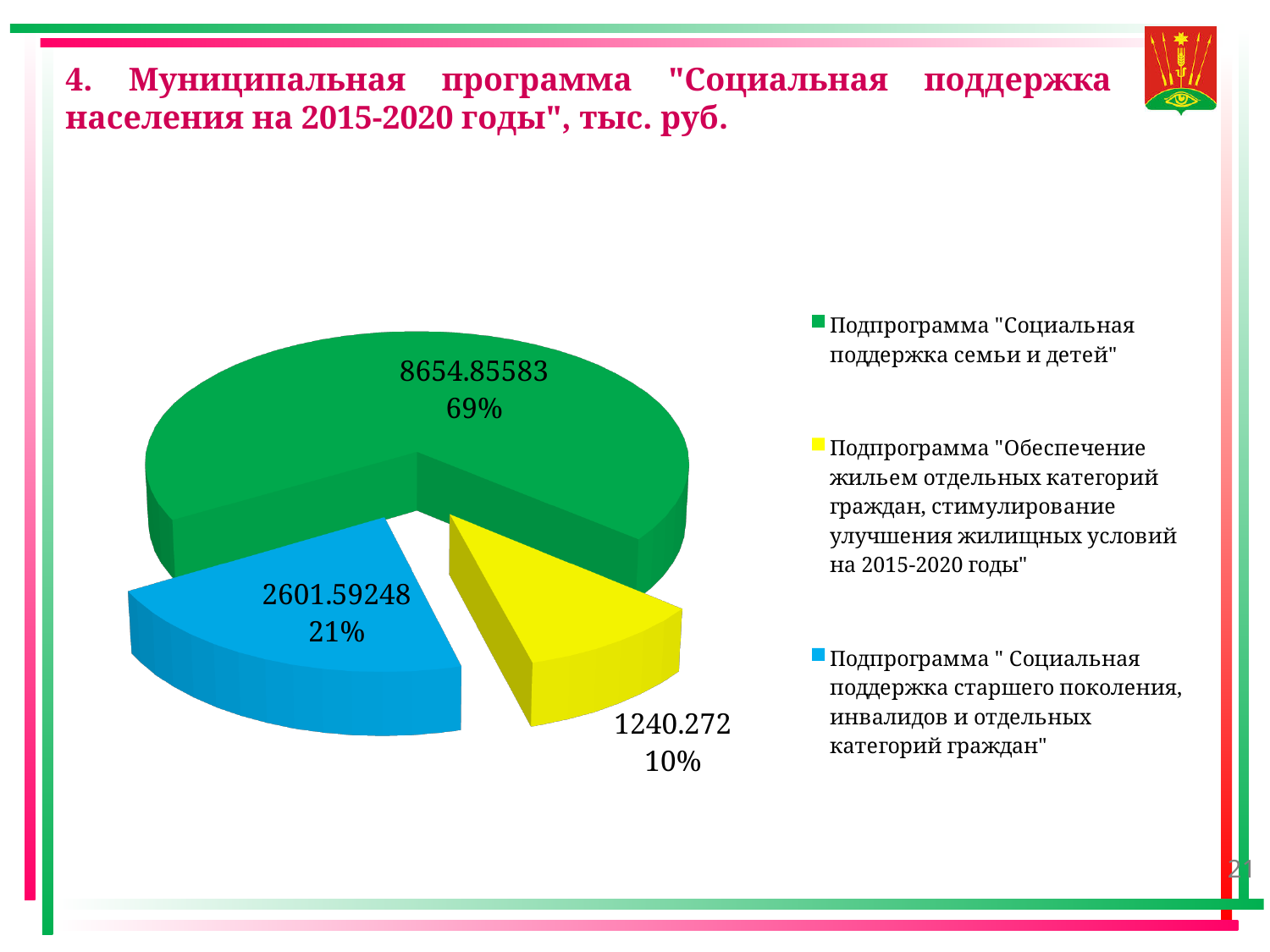
What share of the pie does Подпрограмма "Обеспечение жильем отдельных категорий граждан, стимулирование улучшения жилищных условий на 2015-2020 годы" take? 10% What is the value for Подпрограмма "Социальная поддержка семьи и детей"? 8654.85583 What is the value for Подпрограмма "Обеспечение жильем отдельных категорий граждан, стимулирование улучшения жилищных условий на 2015-2020 годы"? 1240.272 What is the difference between the value for Подпрограмма "Социальная поддержка семьи и детей" and the value for Подпрограмма "Социальная поддержка старшего поколения, инвалидов и отдельных категорий граждан"? 6053.26335 What is the value for Подпрограмма "Социальная поддержка старшего поколения, инвалидов и отдельных категорий граждан"? 2601.59248 What kind of chart is shown on the slide? Pie chart Which subprogram has the largest slice of the pie? Подпрограмма "Социальная поддержка семьи и детей" How many slices does the pie chart have? 3 Which colour represents Подпрограмма "Социальная поддержка старшего поколения, инвалидов и отдельных категорий граждан" in the pie chart? Blue How many entries does the legend of the pie chart list? 3 What share of the pie does Подпрограмма "Социальная поддержка семьи и детей" take? 69% Which subprogram has the smallest slice of the pie? Подпрограмма "Обеспечение жильем отдельных категорий граждан, стимулирование улучшения жилищных условий на 2015-2020 годы"